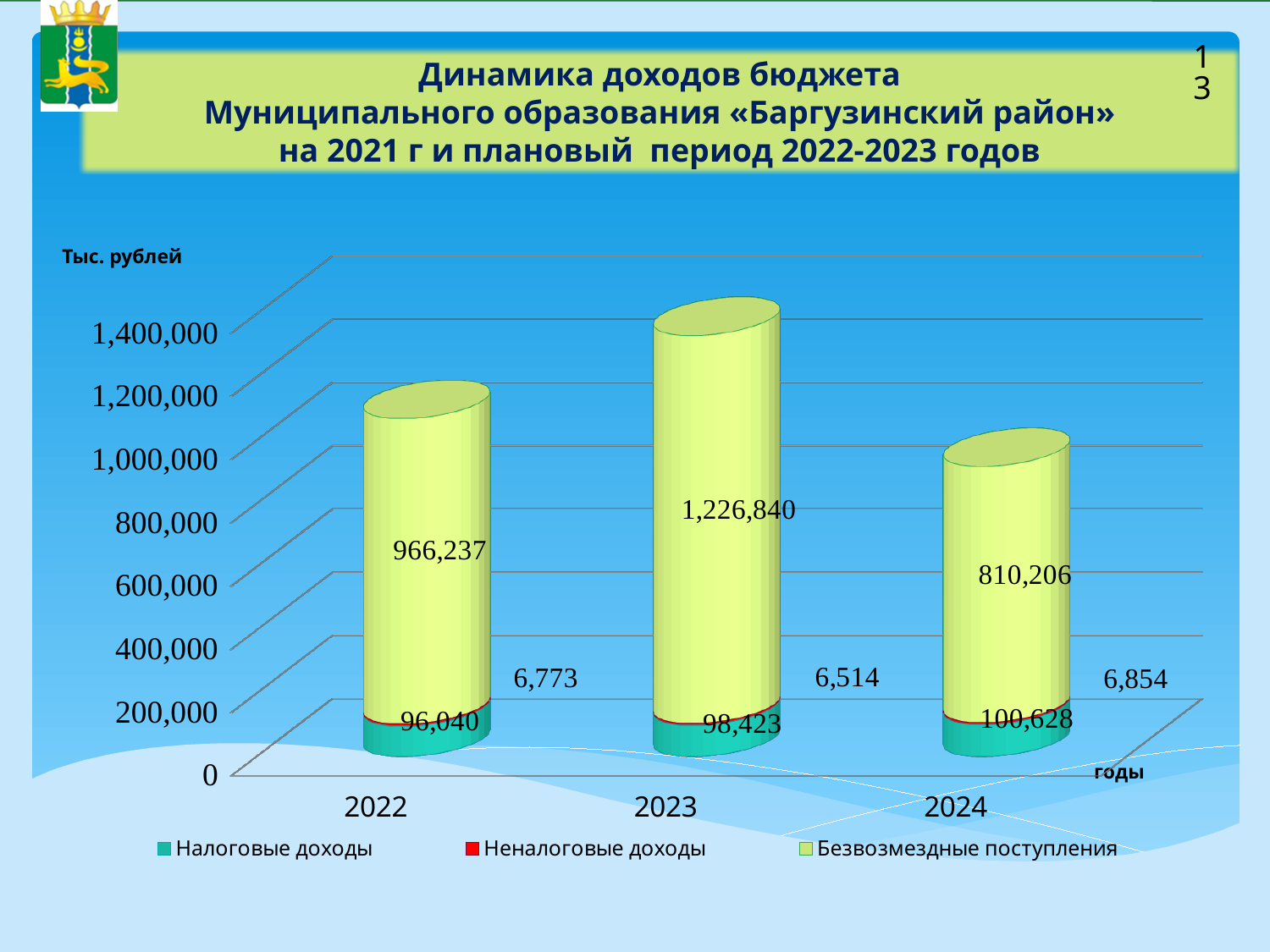
What kind of chart is shown on the slide? Stacked bar chart What is the value of Налоговые доходы for 2022? 96,040 What is the value of Неналоговые доходы for 2024? 6,854 How many years are shown on the x axis? 3 In which year is Неналоговые доходы the lowest? 2023 What is the difference between Безвозмездные поступления in 2023 and in 2022? 260,603 What is the value of Безвозмездные поступления for 2023? 1,226,840 What is the total of the stacked bar for 2024? 917,688 How many series does the legend list? 3 What is the total of the stacked bar for 2023? 1,331,777 Which is larger: Налоговые доходы in 2024 or in 2022? 2024 In which year is Безвозмездные поступления the highest? 2023